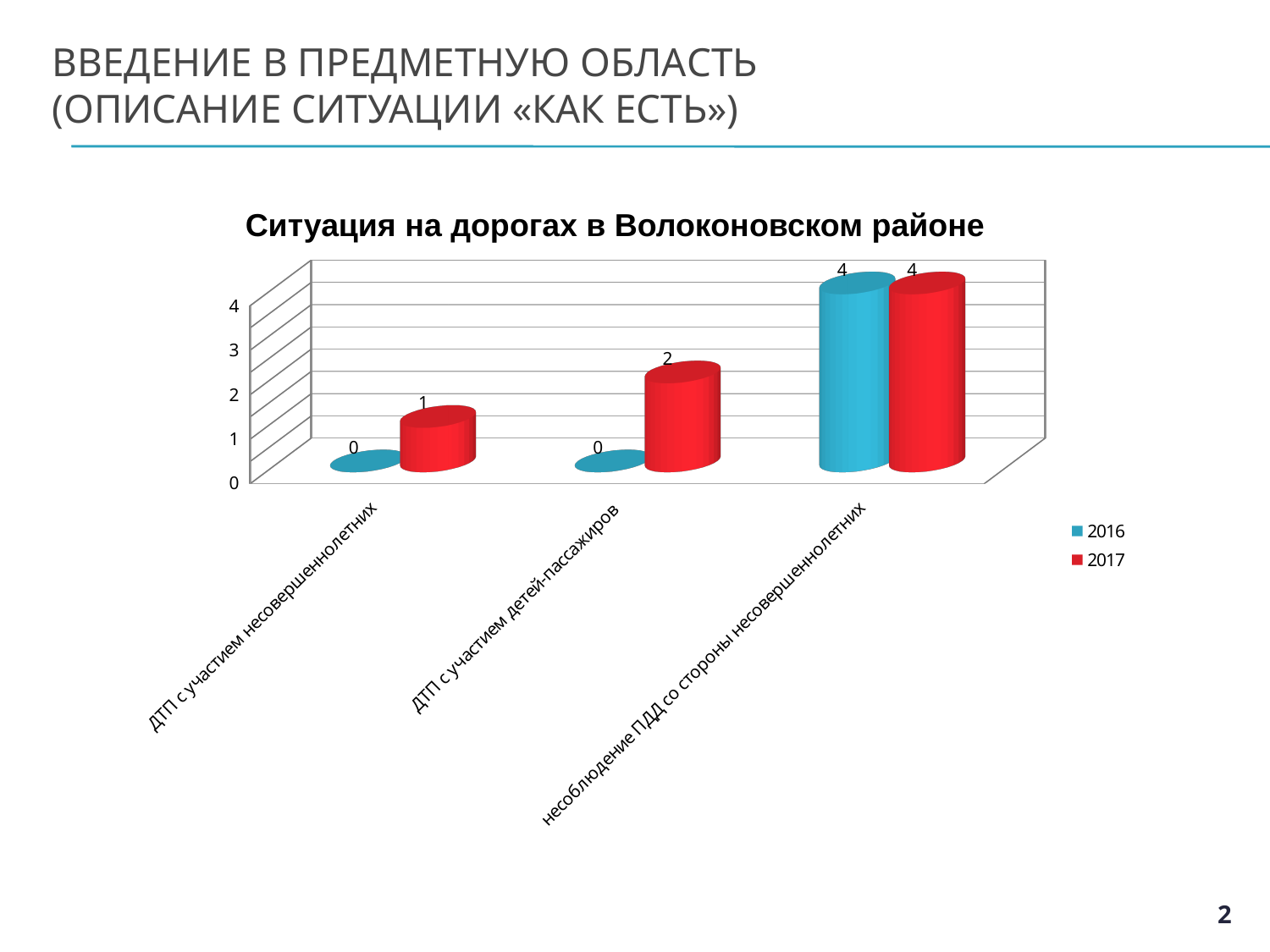
What is the value for 2017 in the category "ДТП с участием детей-пассажиров"? 2 What kind of chart is shown on the slide? bar chart What is the title of the chart? Ситуация на дорогах в Волоконовском районе What is the value for 2017 in the category "ДТП с участием несовершеннолетних"? 1 What is the difference between the 2017 values for "ДТП с участием детей-пассажиров" and "ДТП с участием несовершеннолетних"? 1 What is the value for 2016 in the category "ДТП с участием детей-пассажиров"? 0 How many series does the legend list? 2 How many categories are shown on the x axis of the chart? 3 Which is larger in the category "ДТП с участием детей-пассажиров": the 2016 value or the 2017 value? 2017 Which series is shown in red in the legend? 2017 What is the value for 2016 in the category "несоблюдение ПДД со стороны несовершеннолетних"? 4 Which category has the highest value for the 2017 series? несоблюдение ПДД со стороны несовершеннолетних